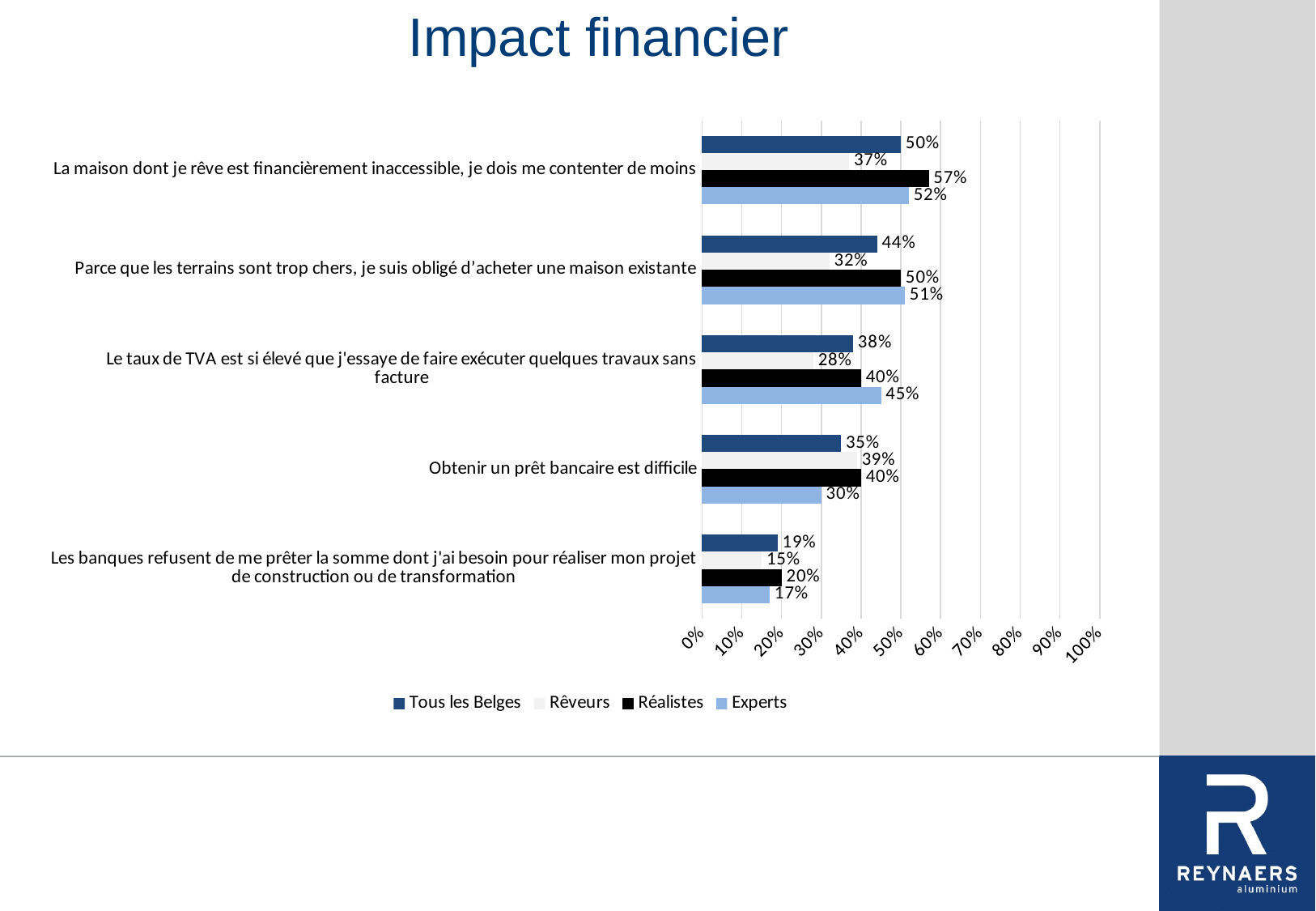
What is the value for Réalistes for "La maison dont je rêve est financièrement inaccessible, je dois me contenter de moins"? 57% How many series does the legend list? 4 What is the title of the slide? Impact financier What is the difference between the Réalistes and Rêveurs values for "La maison dont je rêve est financièrement inaccessible, je dois me contenter de moins"? 20% Which series has the highest value for "Obtenir un prêt bancaire est difficile"? Réalistes Which series has the lowest value for "Les banques refusent de me prêter la somme dont j'ai besoin pour réaliser mon projet de construction ou de transformation"? Rêveurs What is the value for Experts for "Le taux de TVA est si élevé que j'essaye de faire exécuter quelques travaux sans facture"? 45% How many categories (statements) are shown on the chart? 5 For "Le taux de TVA est si élevé que j'essaye de faire exécuter quelques travaux sans facture", which is larger: the Tous les Belges value or the Rêveurs value? Tous les Belges What type of chart is shown on the slide? bar chart What is the value for Rêveurs for "Parce que les terrains sont trop chers, je suis obligé d'acheter une maison existante"? 32% What is the value for Tous les Belges for "Obtenir un prêt bancaire est difficile"? 35%